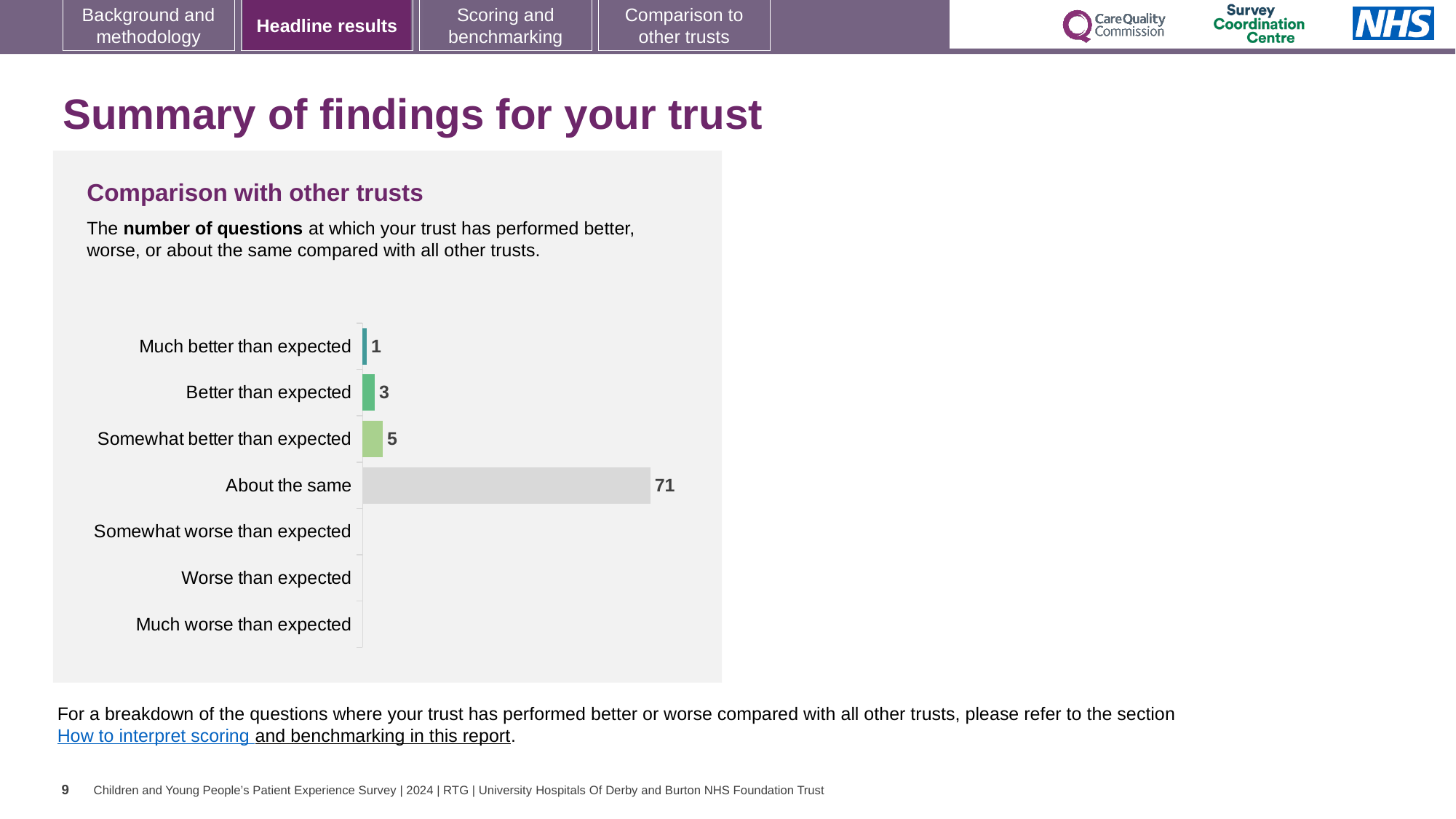
Which is larger, the value for 'Better than expected' or the value for 'Much better than expected'? Better than expected What is the value for 'Much better than expected'? 1 How many categories are listed on the chart? 7 What kind of chart is shown on the slide? Bar chart What is the difference between the values for 'About the same' and 'Somewhat better than expected'? 66 What is the title of the chart? Comparison with other trusts What is the value for 'Somewhat better than expected'? 5 What is the total of the values for 'Much better than expected', 'Better than expected' and 'Somewhat better than expected'? 9 What is the difference between the values for 'Somewhat better than expected' and 'Better than expected'? 2 What is the value for 'About the same'? 71 Which category has the highest value? About the same What is the value for 'Better than expected'? 3